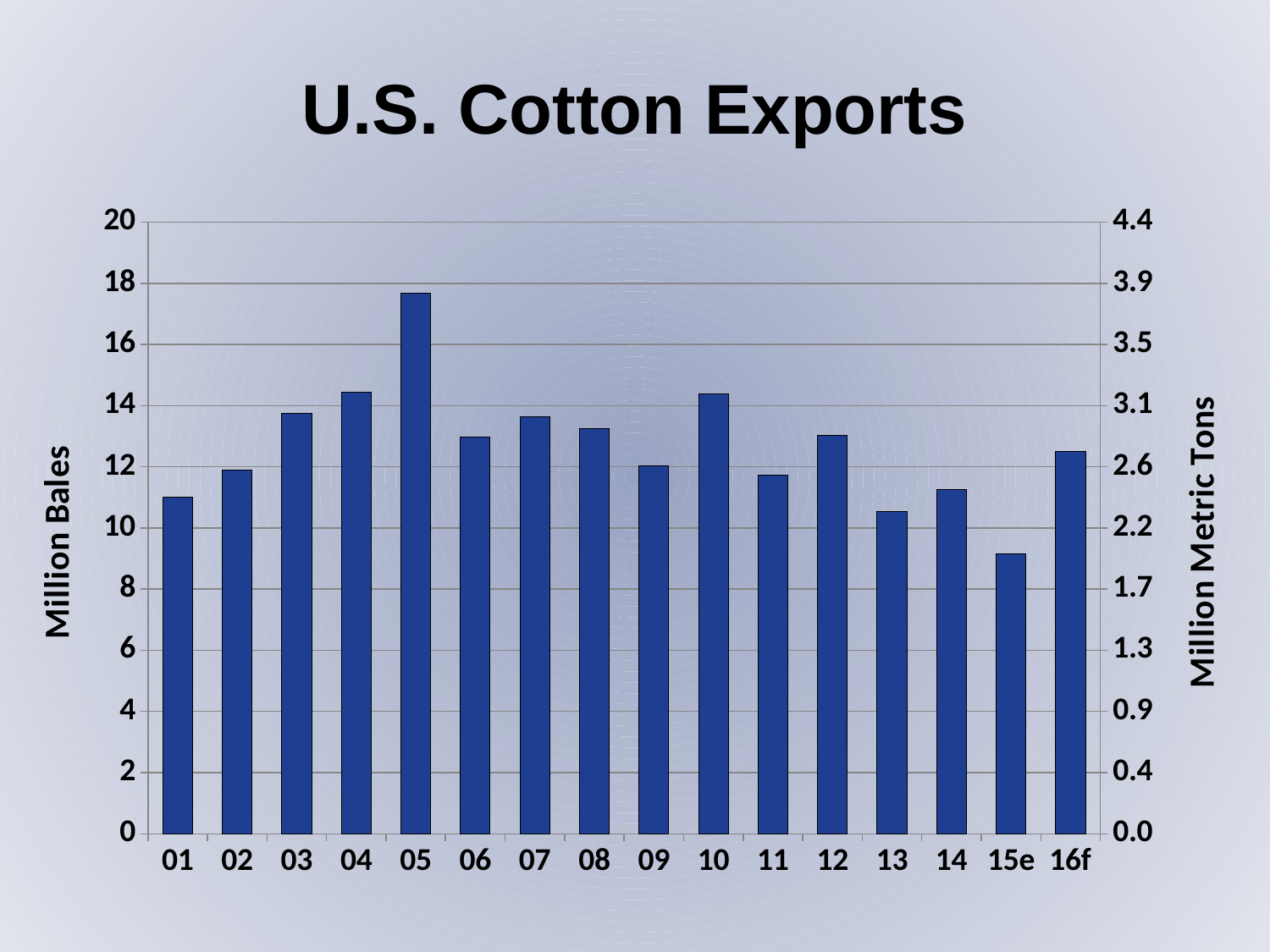
Is the value for 15e greater or less than 10 million bales? less Which is larger, the value for 14 or the value for 15e? 14 Do the values rise or fall from 10 to 15e? fall What kind of chart is shown on the slide? bar chart Which year has the highest cotton exports? 05 What is the label on the right-hand vertical axis? Million Metric Tons Which is larger, the value for 05 or the value for 10? 05 Is the value for 01 greater or less than 10 million bales? greater How many years (bars) are shown on the x axis? 16 Is the value for 05 greater or less than 16 million bales? greater Which year has the lowest cotton exports? 15e What is the title of the chart? U.S. Cotton Exports